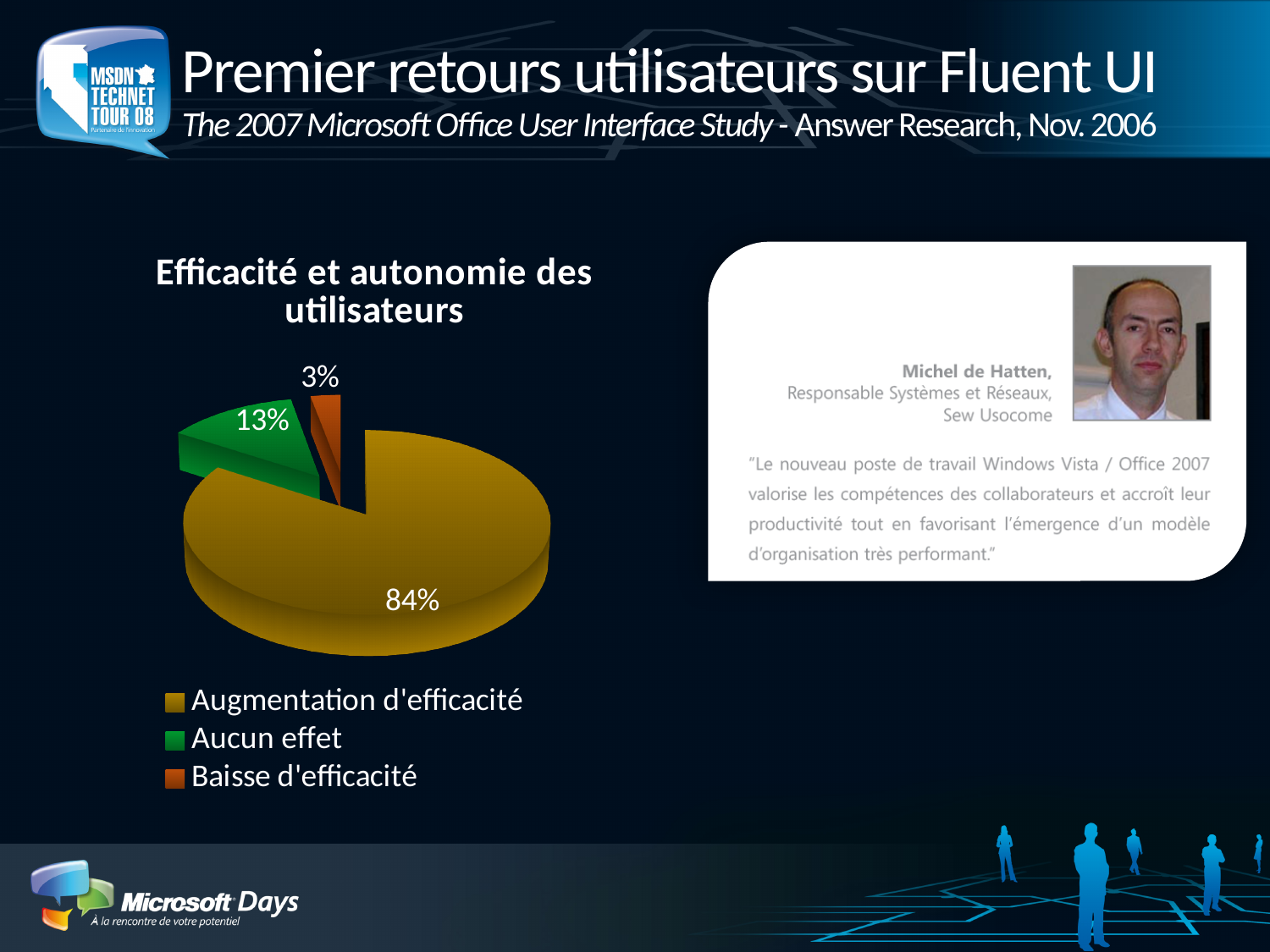
What percentage of the pie is labelled for "Aucun effet"? 13% What is the difference in percentage points between "Augmentation d'efficacité" and "Aucun effet"? 71 How many entries does the legend list? 3 Which is larger, the share for "Aucun effet" or the share for "Baisse d'efficacité"? Aucun effet What percentage of the pie is labelled for "Baisse d'efficacité"? 3% What colour is the slice for "Aucun effet"? green What is the title of the chart on the slide? Efficacité et autonomie des utilisateurs Which category has the largest share of the pie? Augmentation d'efficacité How many slices does the pie chart have? 3 Which category has the smallest share of the pie? Baisse d'efficacité What kind of chart is shown on the slide? pie chart What percentage of the pie is labelled for "Augmentation d'efficacité"? 84%